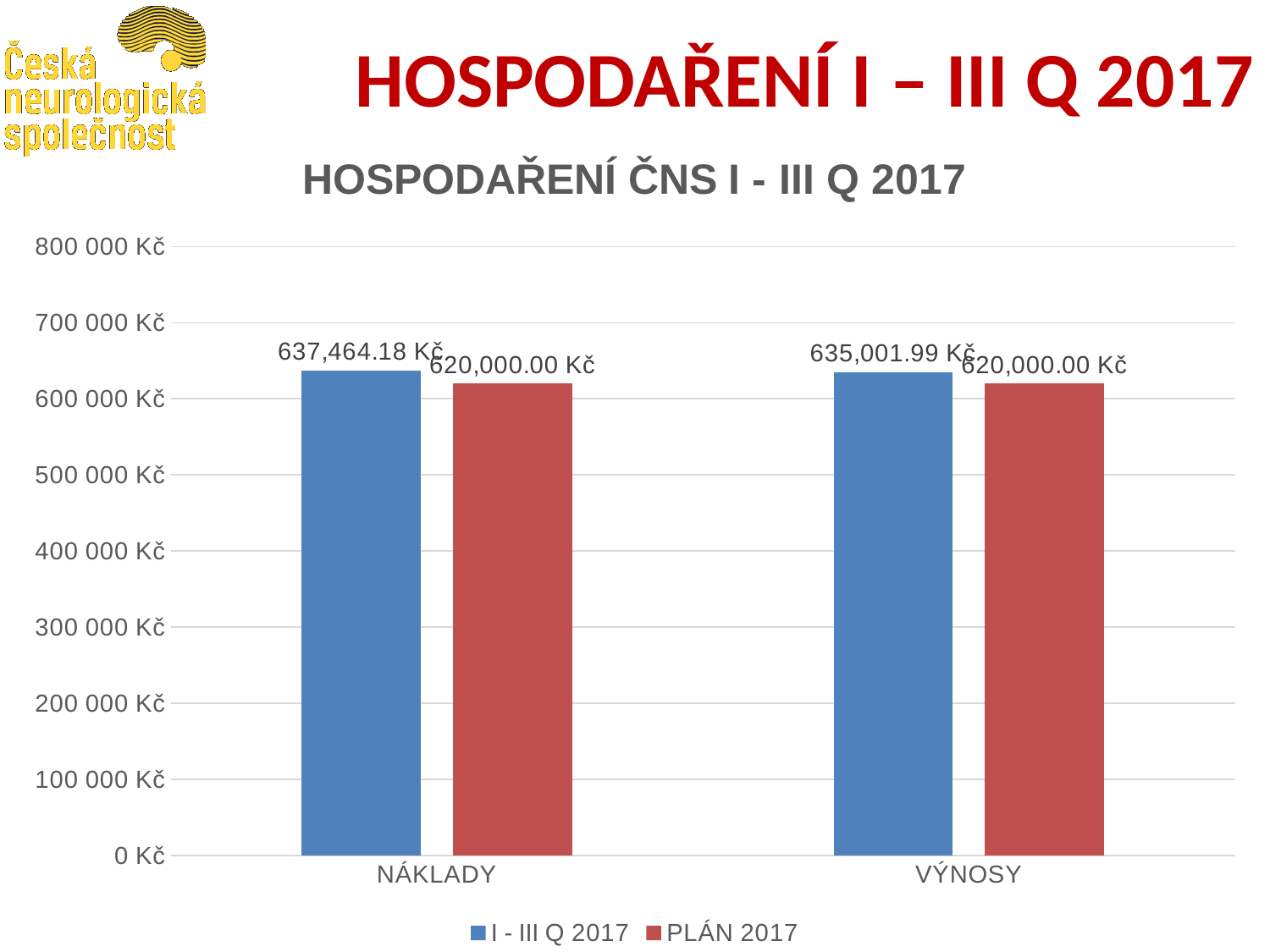
What type of chart is shown on the slide? bar chart What is the difference between the I - III Q 2017 value and the PLÁN 2017 value for NÁKLADY? 17,464.18 Kč What is the value of I - III Q 2017 for VÝNOSY? 635,001.99 Kč What is the difference between the I - III Q 2017 value and the PLÁN 2017 value for VÝNOSY? 15,001.99 Kč For NÁKLADY, which is larger: I - III Q 2017 or PLÁN 2017? I - III Q 2017 What is the PLÁN 2017 value for NÁKLADY? 620,000.00 Kč Is the I - III Q 2017 value for NÁKLADY greater or less than 600 000 Kč? greater What is the title of the chart? HOSPODAŘENÍ ČNS I - III Q 2017 How many series does the legend list? 2 What is the PLÁN 2017 value for VÝNOSY? 620,000.00 Kč How many categories are shown on the x axis? 2 What is the value of I - III Q 2017 for NÁKLADY? 637,464.18 Kč